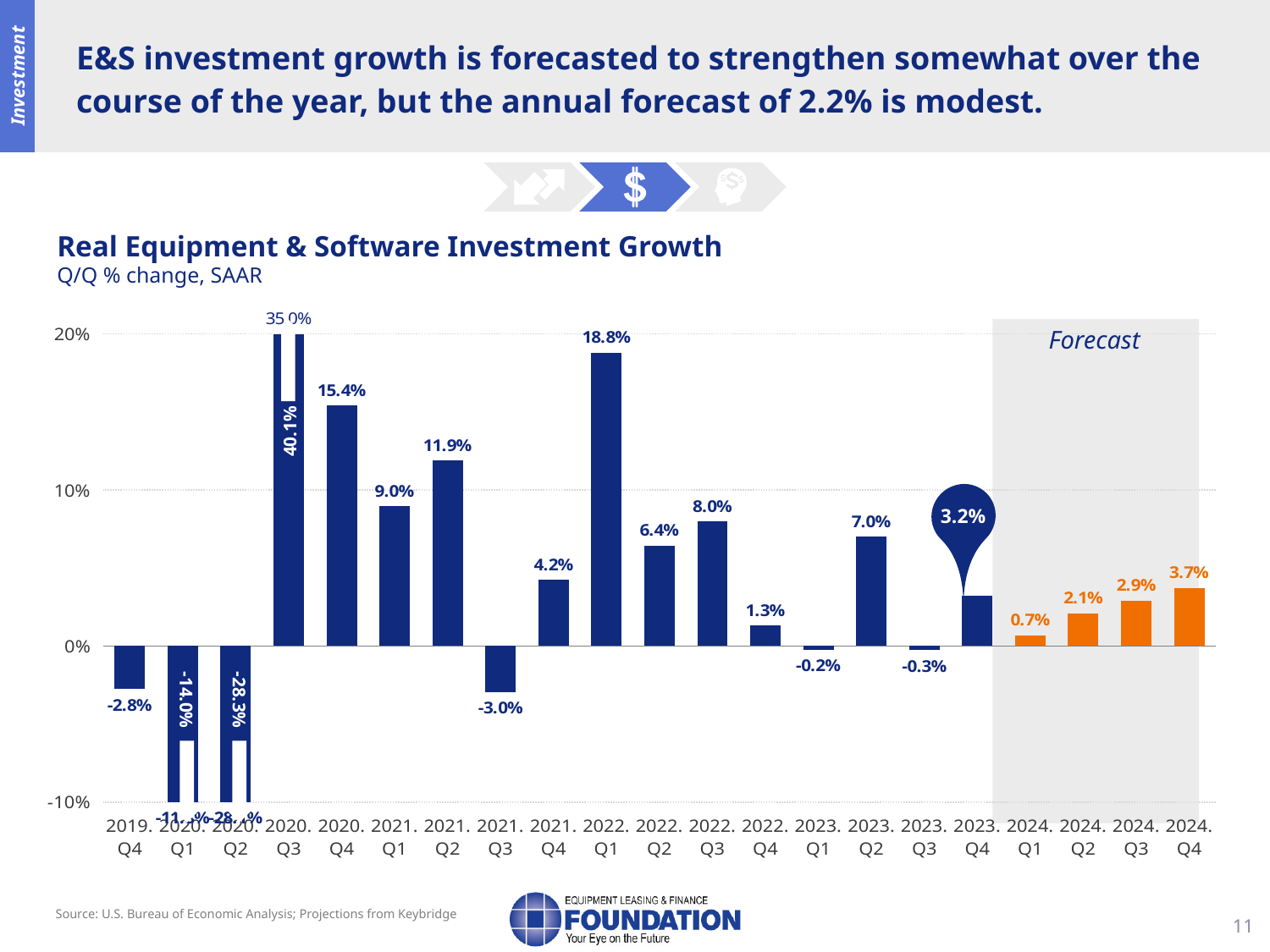
What is the forecast value for 2024 Q4? 3.7% What is the value for 2023 Q4? 3.2% Which is larger, the value for 2022 Q3 or the value for 2023 Q2? 2022 Q3 What is the title of the chart? Real Equipment & Software Investment Growth What type of chart is shown on the slide? Bar chart What is the value for 2020 Q2? -28.3% How many quarters are plotted on the chart? 21 What is the difference between the values for 2022 Q1 and 2020 Q4? 3.4% Do the forecast values rise or fall from 2024 Q1 to 2024 Q4? Rise Which quarter has the lowest value? 2020 Q2 Which quarter has the highest value? 2020 Q3 What is the value for 2022 Q1? 18.8%